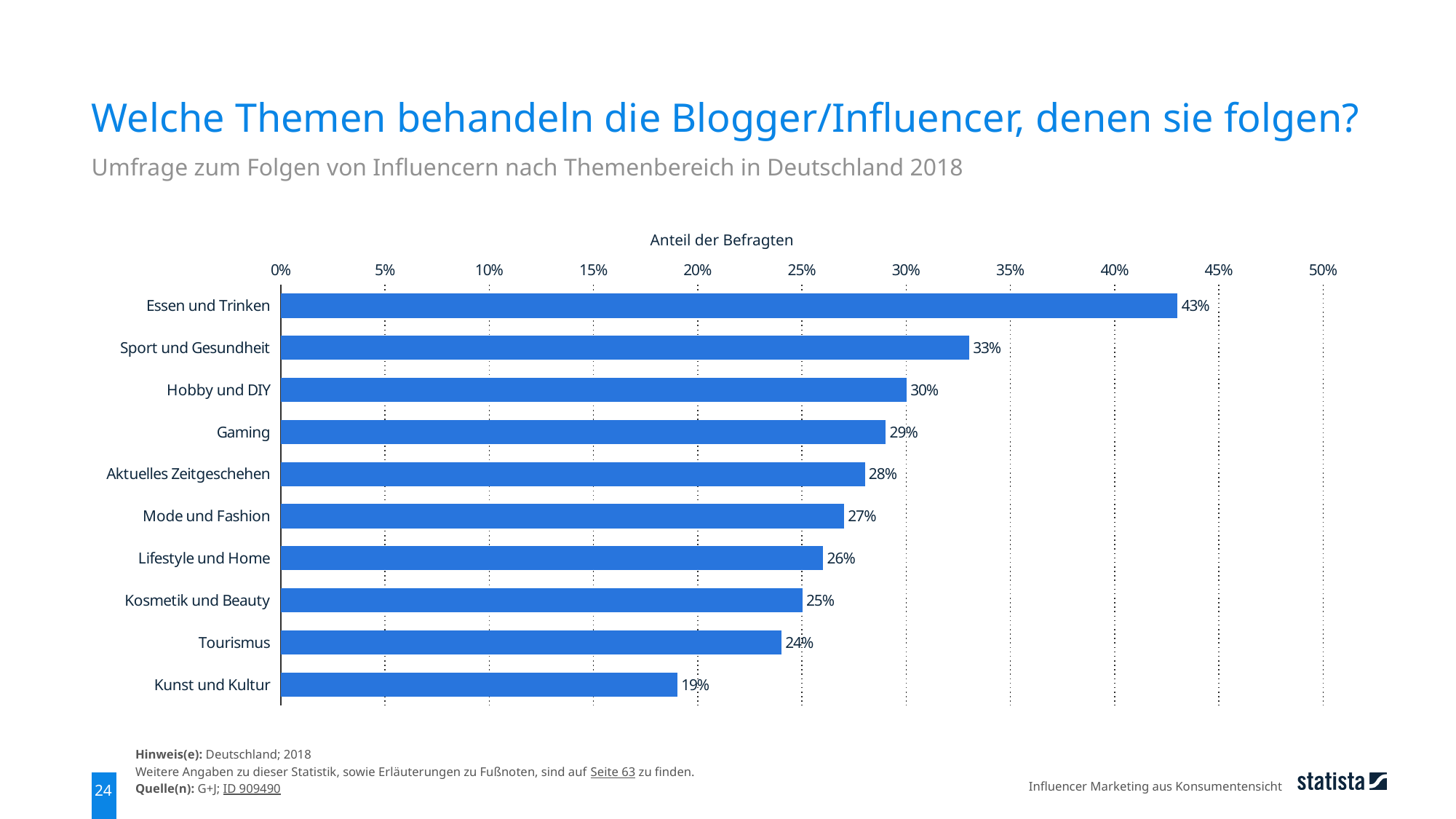
Is the value for Aktuelles Zeitgeschehen greater or less than 25%? greater What is the value for Gaming? 29% What is the difference between the values for Tourismus and Kunst und Kultur? 5% Which is larger, the value for Hobby und DIY or the value for Mode und Fashion? Hobby und DIY What is the value for Kosmetik und Beauty? 25% What kind of chart is shown on the slide? bar chart How many categories are shown in the chart? 10 What is the label of the value axis of the chart? Anteil der Befragten Which category has the lowest value? Kunst und Kultur What is the difference between the values for Essen und Trinken and Sport und Gesundheit? 10% What is the value for Essen und Trinken? 43% Which category has the highest value? Essen und Trinken